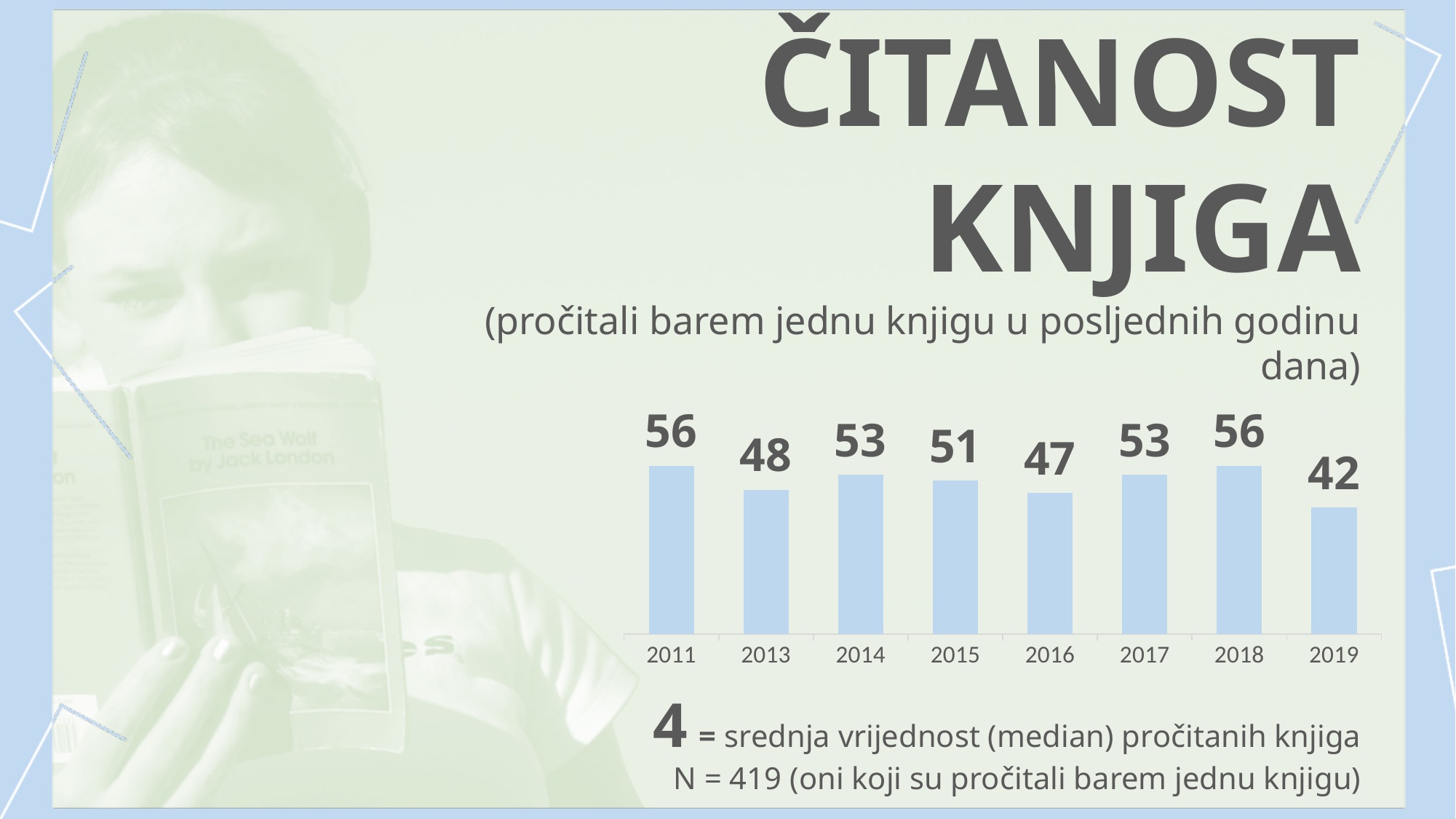
Which years share the highest value? 2011 and 2018 What is the difference between the values for 2018 and 2019? 14 Does the value rise or fall from 2018 to 2019? fall What is the difference between the values for 2014 and 2013? 5 What kind of chart is shown on the slide? bar chart What is the value for 2011? 56 Which is larger, the value for 2013 or the value for 2017? 2017 How many years are shown on the x axis? 8 What is the value for 2019? 42 What is the value for 2015? 51 Which year has the lowest value? 2019 What is the value for 2016? 47